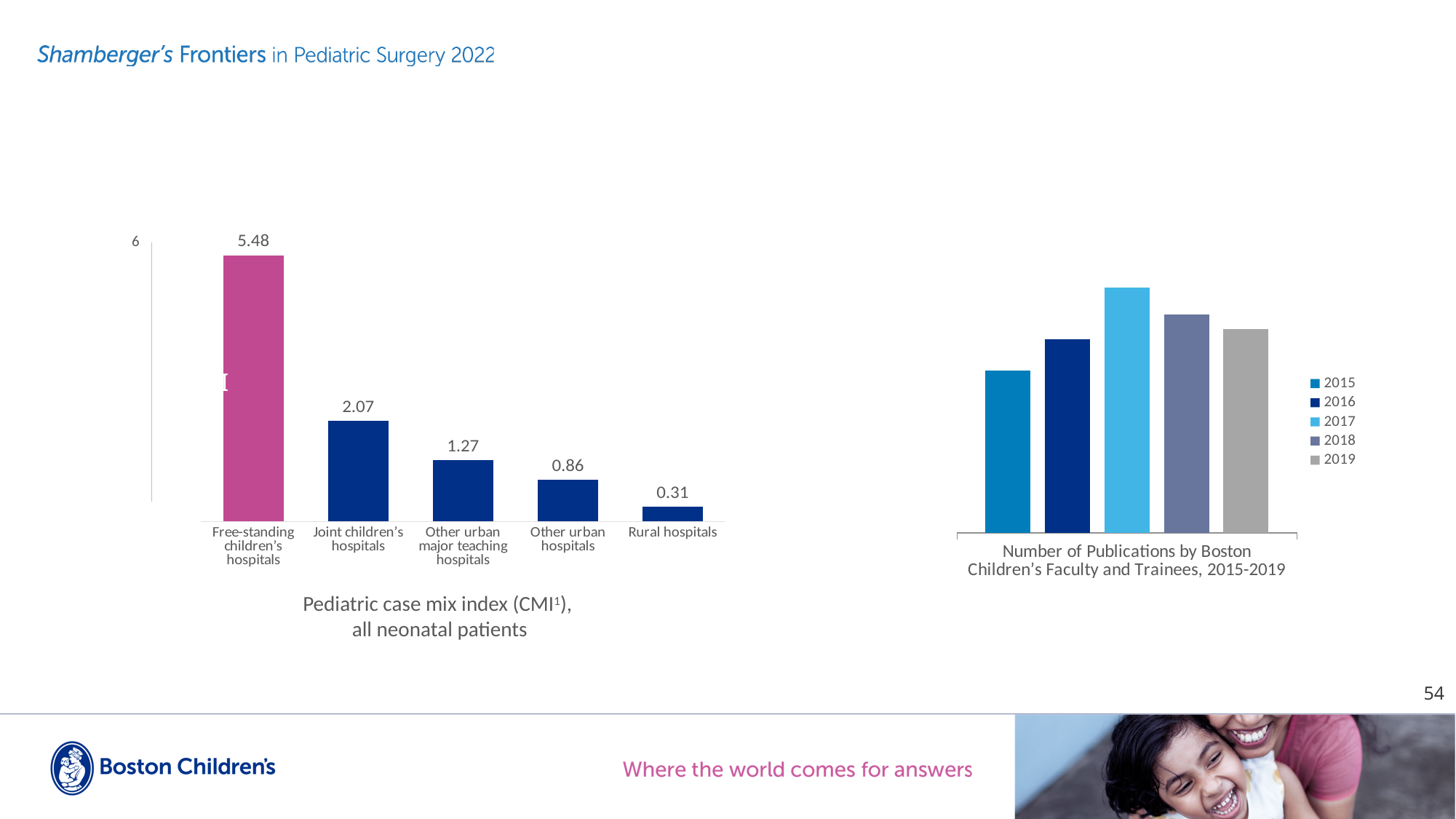
In the 'Number of Publications by Boston Children's Faculty and Trainees, 2015-2019' chart, which year has the highest bar? 2017 In the 'Pediatric case mix index (CMI), all neonatal patients' chart, what is the value for Free-standing children's hospitals? 5.48 In the 'Pediatric case mix index (CMI), all neonatal patients' chart, which category has the lowest value? Rural hospitals In the 'Number of Publications by Boston Children's Faculty and Trainees, 2015-2019' chart, how many entries does the legend list? 5 In the 'Pediatric case mix index (CMI), all neonatal patients' chart, what is the value for Other urban major teaching hospitals? 1.27 In the 'Pediatric case mix index (CMI), all neonatal patients' chart, what is the difference between Free-standing children's hospitals and Joint children's hospitals? 3.41 What kind of chart is the 'Number of Publications by Boston Children's Faculty and Trainees, 2015-2019' chart? bar chart In the 'Pediatric case mix index (CMI), all neonatal patients' chart, what is the value for Rural hospitals? 0.31 In the 'Pediatric case mix index (CMI), all neonatal patients' chart, how many hospital categories are shown? 5 In the 'Pediatric case mix index (CMI), all neonatal patients' chart, do the values rise or fall from left to right? fall In the 'Pediatric case mix index (CMI), all neonatal patients' chart, which is larger: Other urban hospitals or Joint children's hospitals? Joint children's hospitals In the 'Number of Publications by Boston Children's Faculty and Trainees, 2015-2019' chart, which year has the lowest bar? 2015